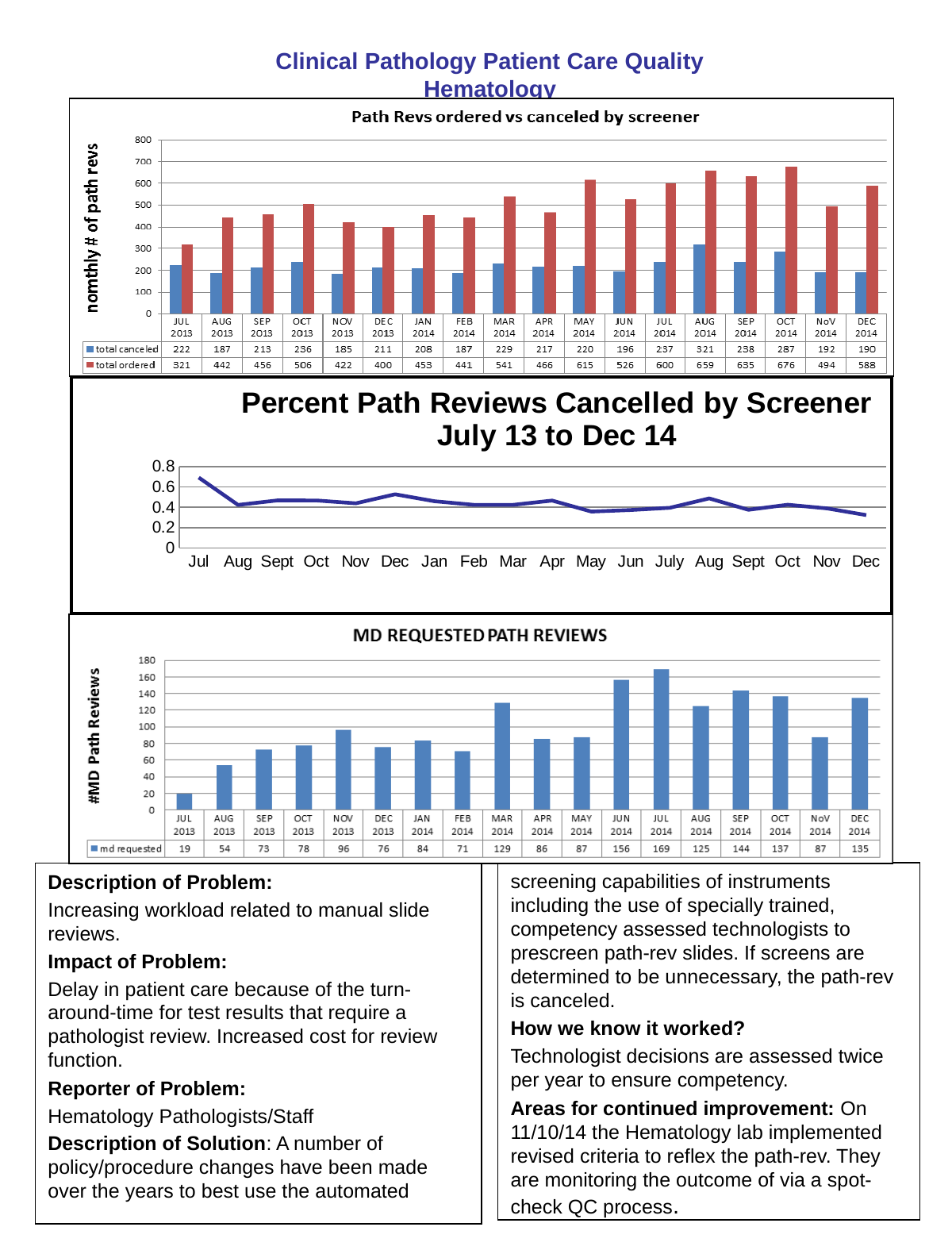
In the 'MD REQUESTED PATH REVIEWS' chart, which is larger, the value for JUN 2014 or SEP 2014? JUN 2014 In the 'MD REQUESTED PATH REVIEWS' chart, which month has the highest number of MD requested path reviews? JUL 2014 In the 'Path Revs ordered vs canceled by screener' chart, which month has the highest total ordered value? OCT 2014 In the 'MD REQUESTED PATH REVIEWS' chart, which month has the lowest number of MD requested path reviews? JUL 2013 What kind of chart is 'Percent Path Reviews Cancelled by Screener July 13 to Dec 14'? line chart How many months are plotted in the 'Percent Path Reviews Cancelled by Screener' chart? 18 In the 'Percent Path Reviews Cancelled by Screener' chart, is the value for Jul greater or less than 0.6? greater In the 'Path Revs ordered vs canceled by screener' chart, what is the total canceled value for AUG 2014? 321 In the 'MD REQUESTED PATH REVIEWS' chart, what is the md requested value for NOV 2013? 96 In the 'Path Revs ordered vs canceled by screener' chart, what is the total ordered value for OCT 2014? 676 How many series does the legend of the 'Path Revs ordered vs canceled by screener' chart list? 2 In the 'Path Revs ordered vs canceled by screener' chart, what is the difference between total ordered and total canceled for OCT 2014? 389